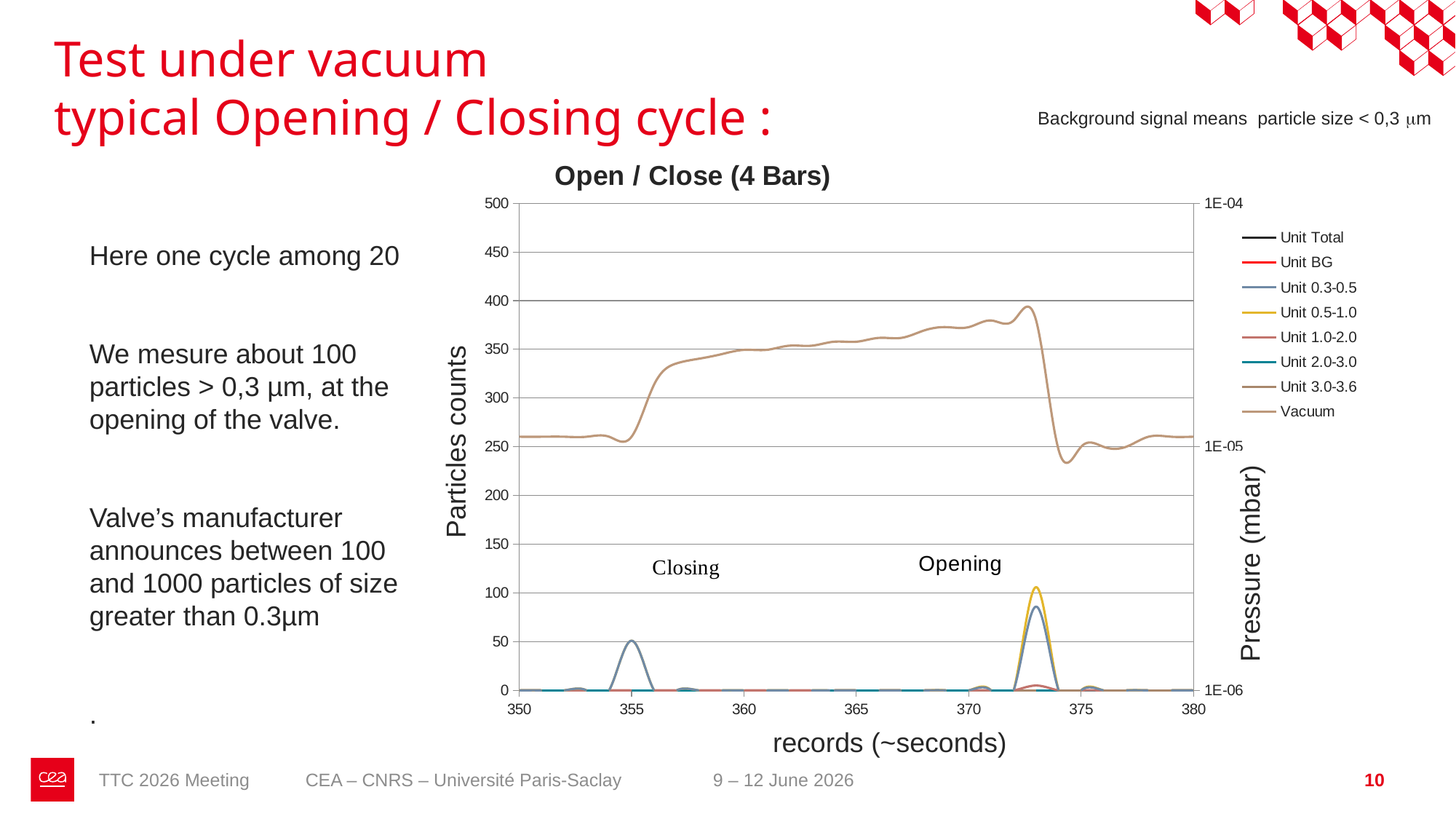
Is the peak value of Unit 0.5-1.0 near record 373 greater or less than 50 particles? greater Is the peak value of Unit 0.3-0.5 near record 373 greater or less than 50 particles? greater How many series does the chart legend list? 8 Does the Vacuum pressure rise or fall between records 356 and 372? rise Is the peak value of Unit 0.3-0.5 near record 355 greater or less than 100 particles? less What is the label of the x axis of the chart? records (~seconds) What is the title of the chart? Open / Close (4 Bars) What kind of chart is shown on the slide? line chart Does the Vacuum pressure rise or fall between records 373 and 374? fall Which particle-count peak is larger: the one at Closing (around record 355) or the one at Opening (around record 373)? Opening